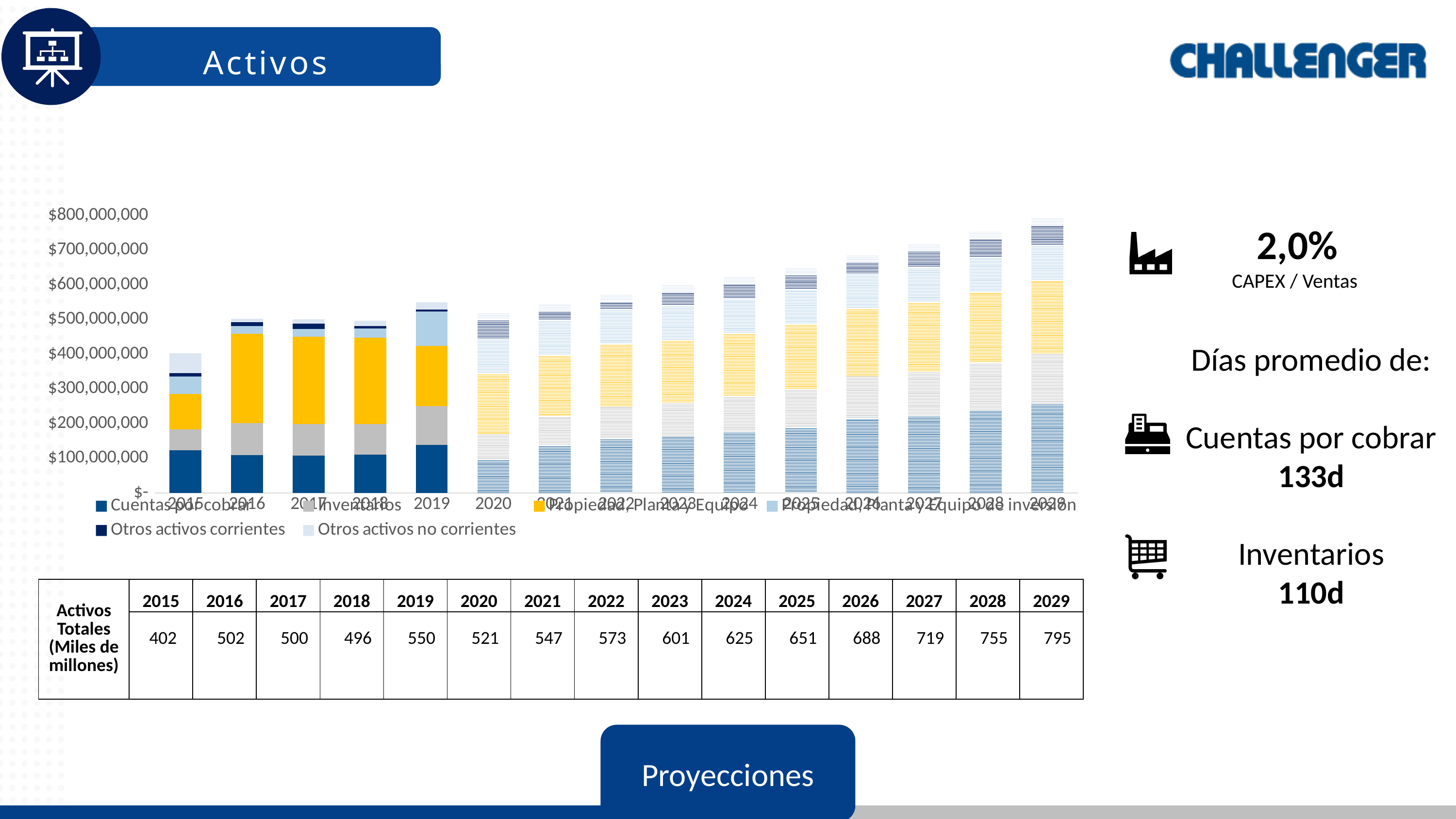
According to the table below the chart, what are the Activos Totales (Miles de millones) for 2029? 795 Is the total bar height for 2026 greater or less than $700,000,000? less How many series does the chart legend list? 6 Which series is shown in yellow in the chart legend? Propiedad, Planta y Equipo Do the stacked bars generally rise or fall from 2020 to 2029? rise Which year has the tallest stacked bar in the chart? 2029 Is the total bar height for 2015 greater or less than $500,000,000? less Is the total bar height for 2019 greater or less than $500,000,000? greater What kind of chart is shown on the slide? stacked bar chart Which year has the shortest stacked bar in the chart? 2015 How many years are shown on the x axis of the chart? 15